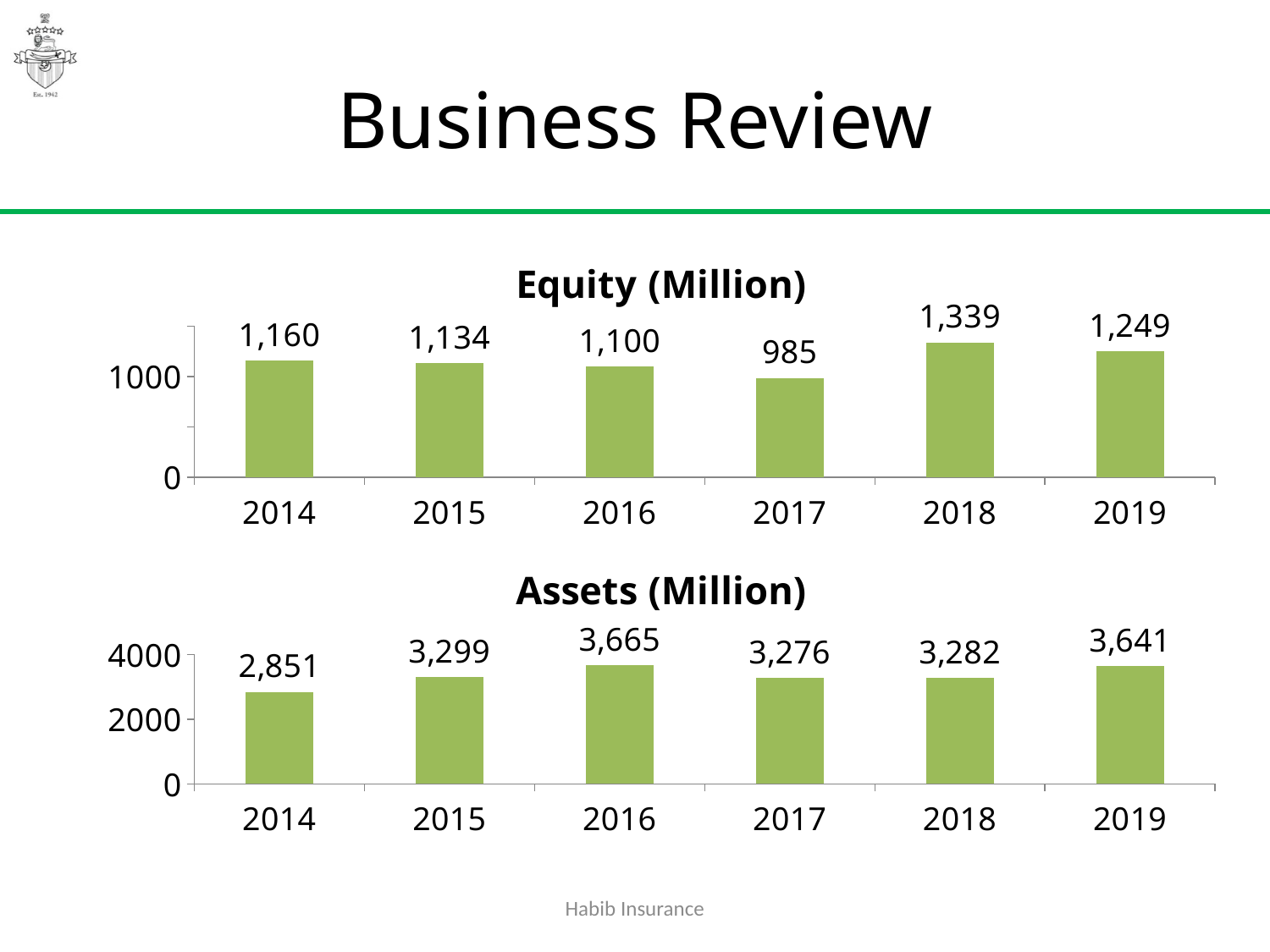
What kind of chart is the Assets (Million) chart? bar chart What is the title of the top chart on the slide? Equity (Million) How many years are shown in the Equity (Million) chart? 6 In the Equity (Million) chart, which year has the highest value? 2018 In the Assets (Million) chart, is the value for 2014 greater or less than 2000? greater In the Equity (Million) chart, what is the value for 2017? 985 In the Assets (Million) chart, what is the value for 2014? 2,851 In the Assets (Million) chart, what is the difference between the 2016 and 2015 values? 366 In the Equity (Million) chart, do the values rise or fall from 2014 to 2017? fall In the Assets (Million) chart, which year has the lowest value? 2014 In the Equity (Million) chart, which is larger, the value for 2014 or the value for 2019? 2019 In the Equity (Million) chart, what is the difference between the 2018 and 2017 values? 354